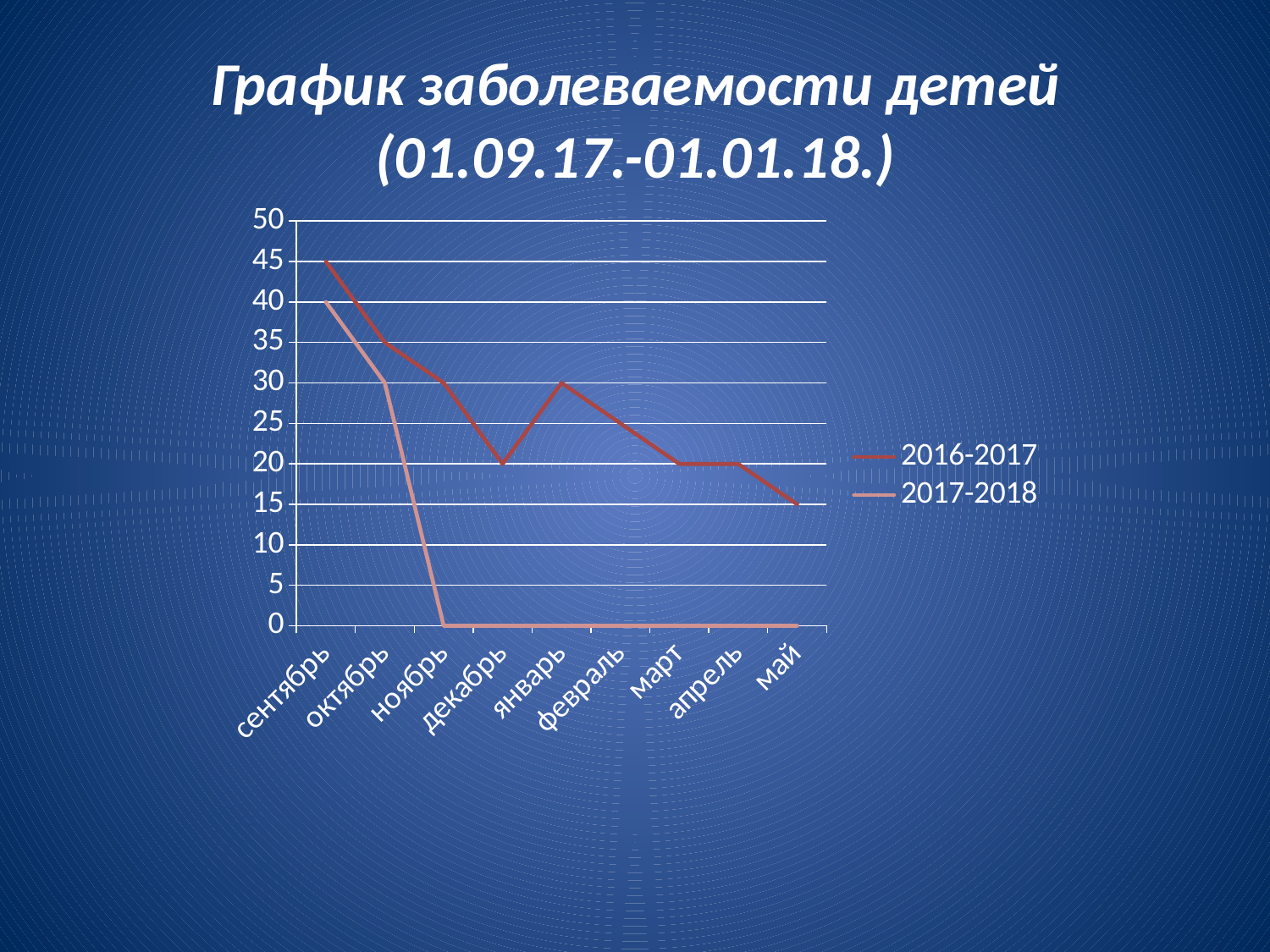
In which month does the 2016-2017 series reach its lowest value? май What is the value for октябрь in the 2017-2018 series? 30 What kind of chart is shown on the slide? line chart How many series does the legend list? 2 How many months are shown on the x axis? 9 What is the value for сентябрь in the 2017-2018 series? 40 Which series has the larger value for октябрь, 2016-2017 or 2017-2018? 2016-2017 What is the value for май in the 2016-2017 series? 15 In which month does the 2016-2017 series reach its highest value? сентябрь What is the value for сентябрь in the 2016-2017 series? 45 Does the 2017-2018 series rise or fall from сентябрь to ноябрь? fall What is the difference between the 2016-2017 and 2017-2018 values for сентябрь? 5